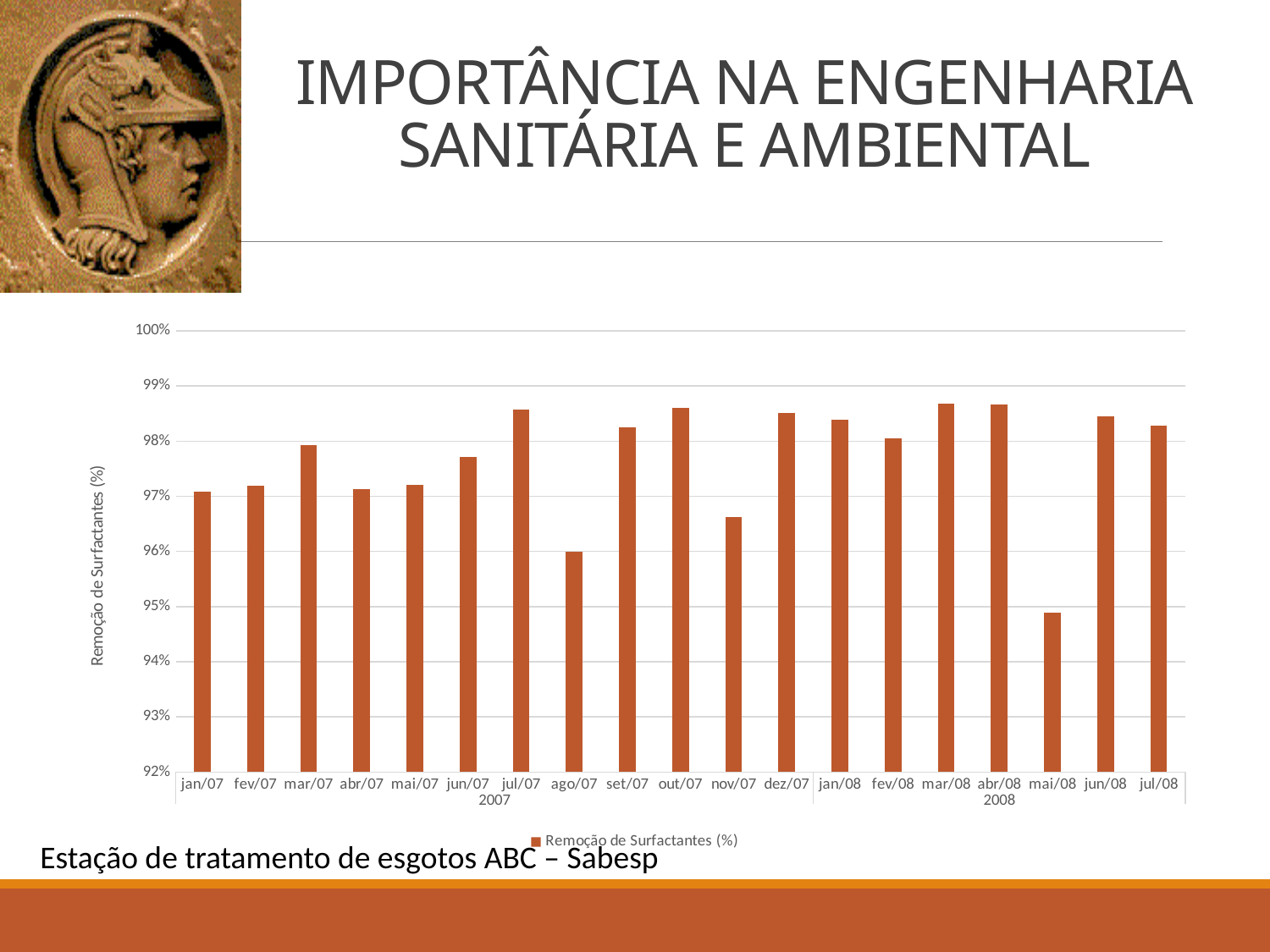
Is the value for ago/07 greater or less than 97%? less Is the value for jul/07 greater or less than 98%? greater Is the value for mai/08 greater or less than 95%? less What series name appears in the chart legend? Remoção de Surfactantes (%) Which is larger, the value for mai/08 or the value for jun/08? jun/08 How many series does the chart legend list? 1 What kind of chart is shown on the slide? bar chart Which is larger, the value for ago/07 or the value for set/07? set/07 Which month has the lowest surfactant removal value? mai/08 What is the label of the vertical axis? Remoção de Surfactantes (%) How many months (bars) are plotted in the chart? 19